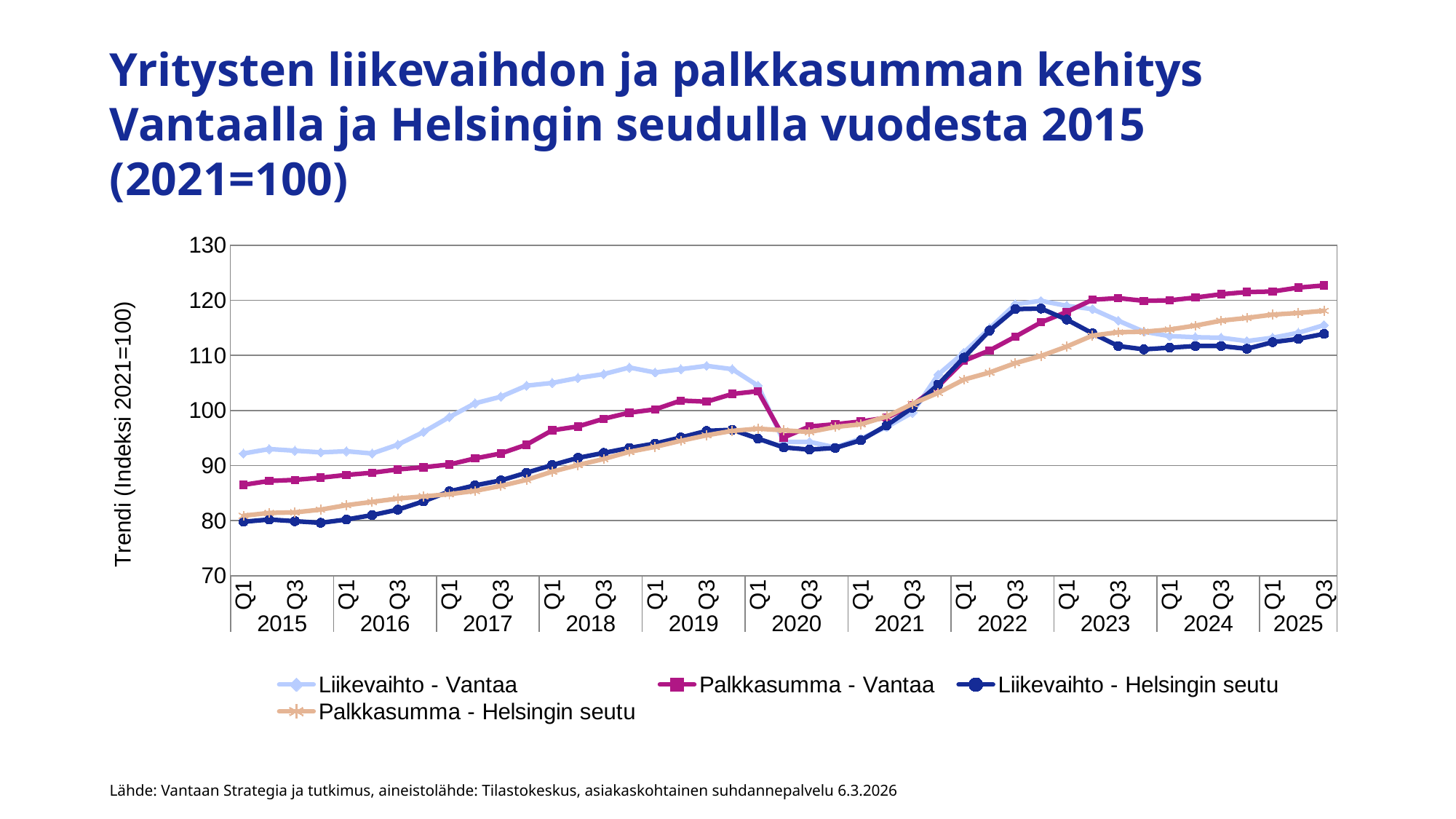
What kind of chart is shown on the slide? line chart What is the label of the vertical axis? Trendi (Indeksi 2021=100) What is the title of the chart on the slide? Yritysten liikevaihdon ja palkkasumman kehitys Vantaalla ja Helsingin seudulla vuodesta 2015 (2021=100) Is the value for Palkkasumma - Vantaa at Q1 2015 greater or less than 90? less Which series has the highest value at Q3 2025? Palkkasumma - Vantaa At Q1 2015, which is larger: Liikevaihto - Vantaa or Liikevaihto - Helsingin seutu? Liikevaihto - Vantaa How many years are labelled along the x axis? 11 How many series does the legend list? 4 Is the value for Liikevaihto - Vantaa at Q3 2019 greater or less than 100? greater Is the value for Palkkasumma - Vantaa at Q3 2025 greater or less than 120? greater Which series has the highest value at Q3 2019? Liikevaihto - Vantaa